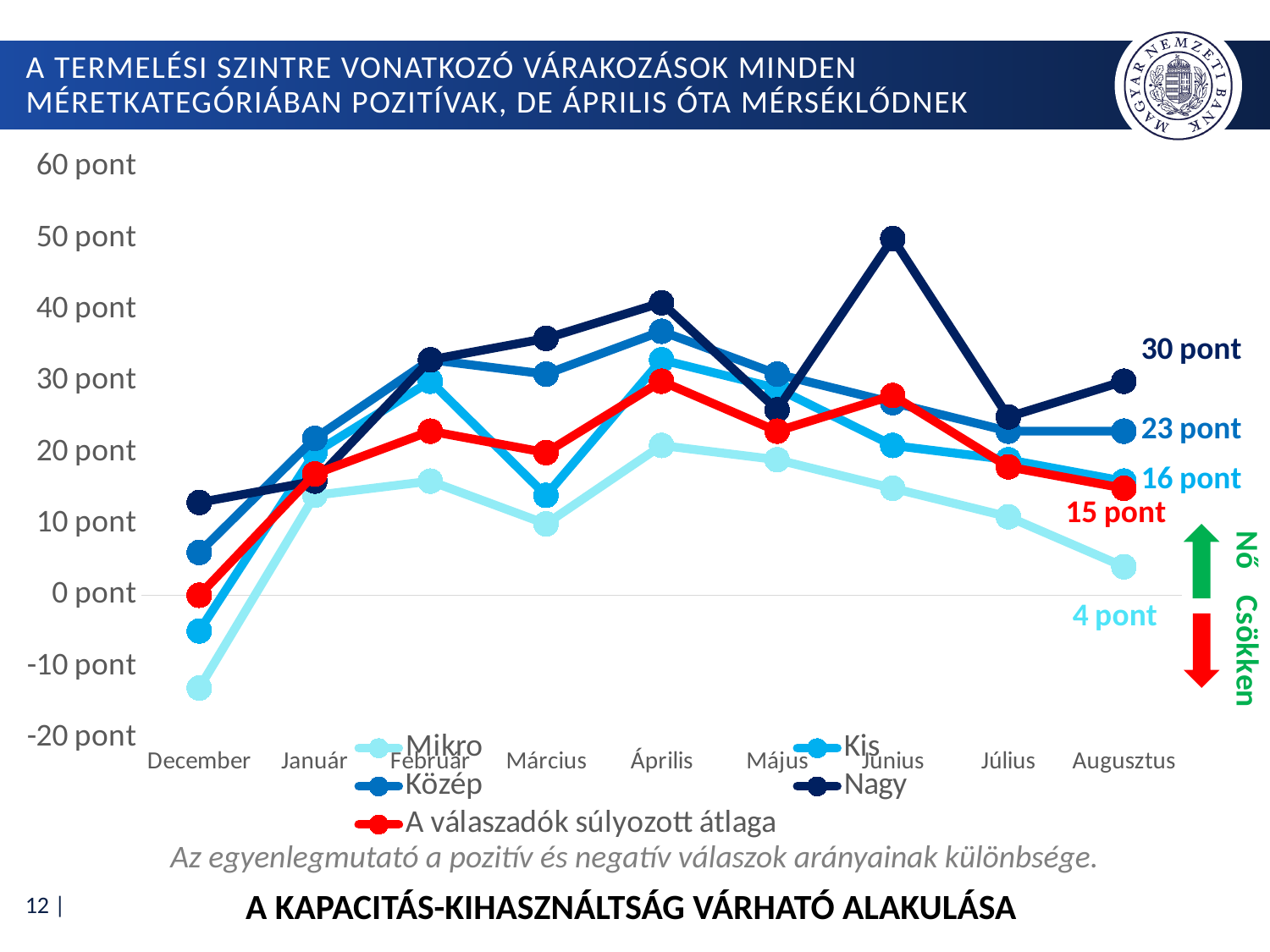
What is the value for Nagy in Augusztus? 30 pont What is the value for Közép in Augusztus? 23 pont How many series does the legend list? 5 What kind of chart is shown on the slide? line chart What is the value for Kis in Augusztus? 16 pont How many months are shown on the x axis? 9 Is the value for Nagy in Június greater or less than 40 pont? greater Which series has the highest value in Augusztus? Nagy What is the difference between the Nagy and Mikro values in Augusztus? 26 pont What is the value for Mikro in Augusztus? 4 pont Which series has the lowest value in Augusztus? Mikro What is the value for A válaszadók súlyozott átlaga in Augusztus? 15 pont